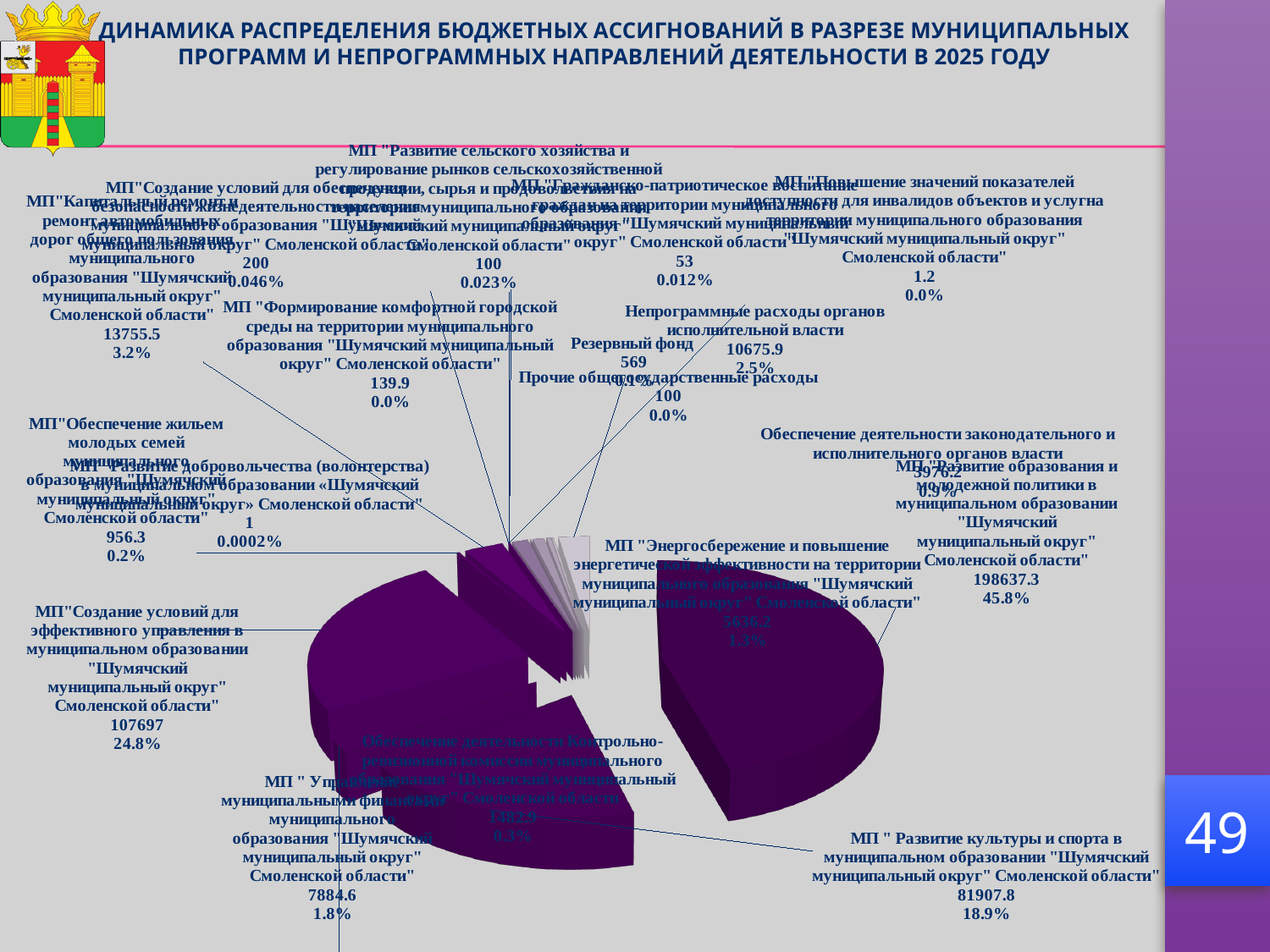
What is the value shown for "Резервный фонд"? 569 What share is shown for the program "Создание условий для эффективного управления"? 24.8% What share of the budget goes to the program "Развитие образования и молодежной политики"? 45.8% Which program has the largest slice of the pie? МП "Развитие образования и молодежной политики" What share is shown for the program "Управление муниципальными финансами"? 1.8% What is the value shown for the program "Капитальный ремонт и ремонт автомобильных дорог"? 13755.5 What kind of chart is shown on the slide? pie chart What is the value shown for the program "Развитие культуры и спорта"? 81907.8 What is the difference between the values for "Развитие образования и молодежной политики" and "Создание условий для эффективного управления"? 90940.3 Which is larger: the value for "Развитие культуры и спорта" or for "Создание условий для эффективного управления"? Создание условий для эффективного управления What is the value shown for "Непрограммные расходы органов исполнительной власти"? 10675.9 What year does the chart title refer to? 2025